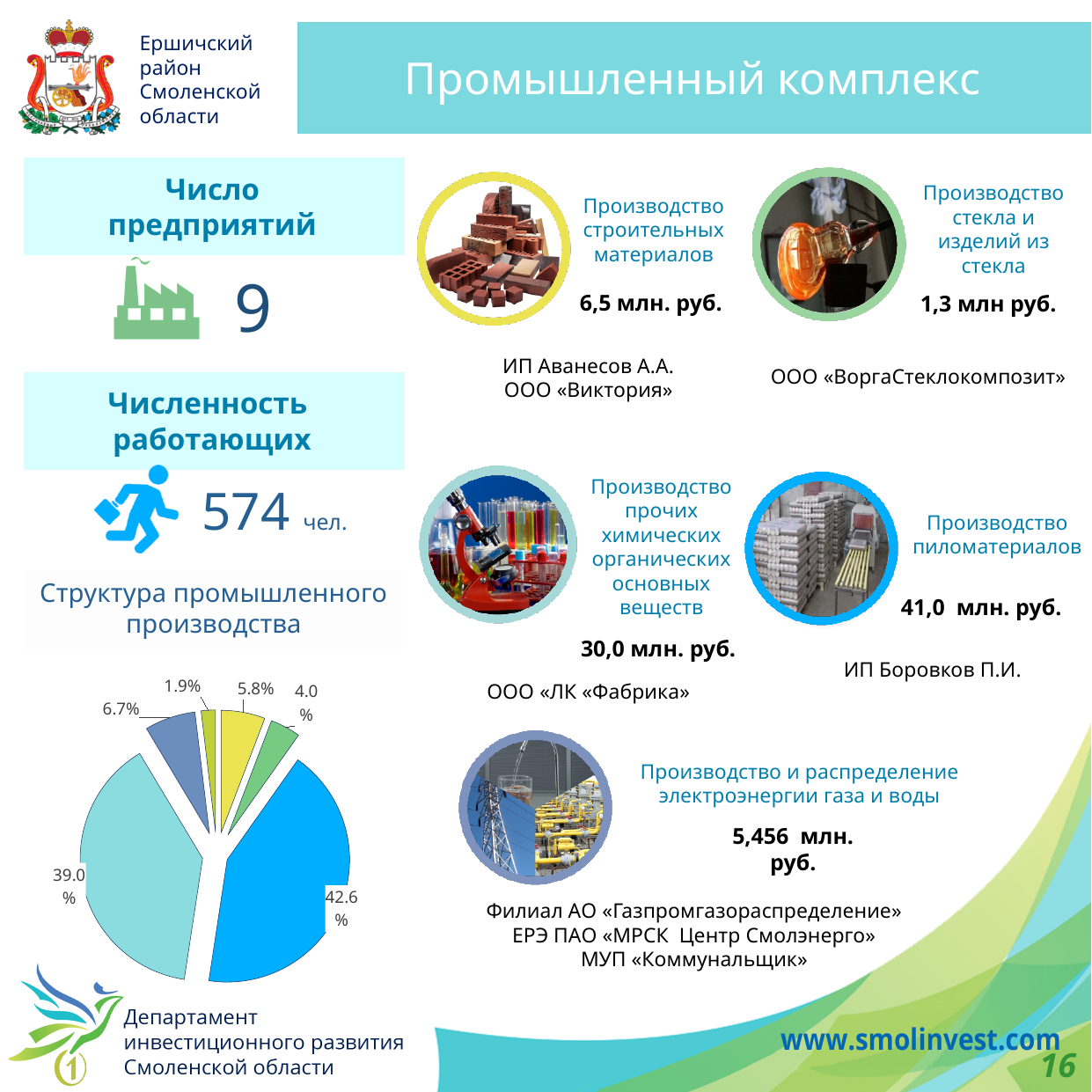
What is the title shown above the pie chart on the slide? Структура промышленного производства In the pie chart «Структура промышленного производства», what do the two largest slices (42.6% and 39.0%) add up to? 81.6% In the pie chart «Структура промышленного производства», what is the value of the yellow slice? 5.8% In the pie chart «Структура промышленного производства», which is larger: the slice labelled 6.7% or the slice labelled 5.8%? 6.7% In the pie chart «Структура промышленного производства», what is the value of the green slice? 4.0% What is the value of the smallest slice in the pie chart «Структура промышленного производства»? 1.9% What kind of chart is shown under the heading «Структура промышленного производства»? pie chart In the pie chart «Структура промышленного производства», what is the value of the second-largest slice? 39.0% What colour is the largest slice (42.6%) in the pie chart «Структура промышленного производства»? blue In the pie chart «Структура промышленного производства», what is the difference between the two largest slices (42.6% and 39.0%)? 3.6 percentage points How many slices does the pie chart «Структура промышленного производства» have? 6 What is the value of the largest slice in the pie chart «Структура промышленного производства»? 42.6%